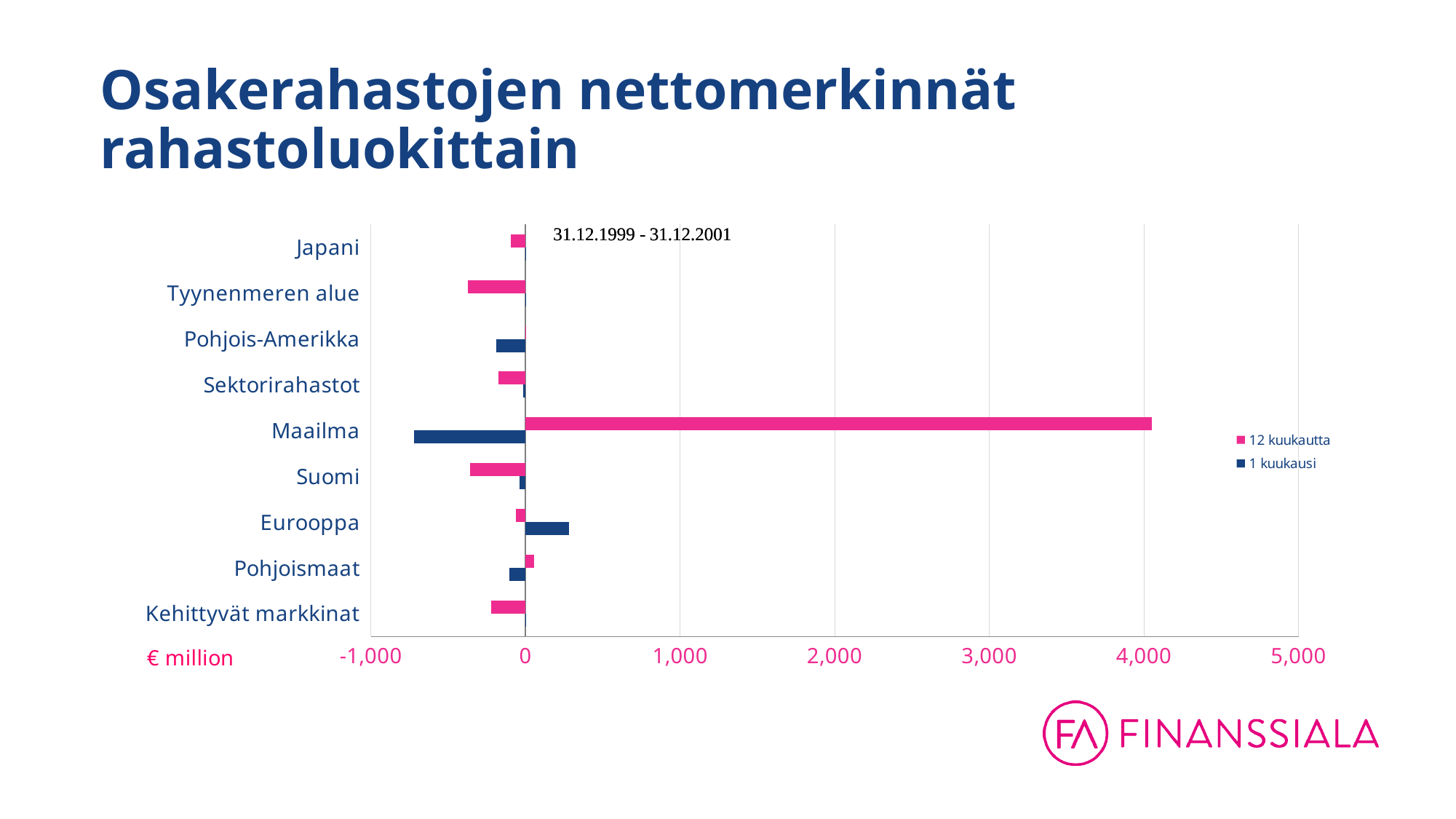
Which has the larger 1 kuukausi value, Eurooppa or Pohjoismaat? Eurooppa How many series does the chart's legend list? 2 Which category has the lowest value for the 1 kuukausi series? Maailma Is the 1 kuukausi value for Maailma greater or less than -500? less How many fund categories are listed on the vertical axis of the chart? 9 What kind of chart is shown on the slide? bar chart Which category has the highest value for the 12 kuukautta series? Maailma Which has the larger 12 kuukautta value, Maailma or Suomi? Maailma What date range is printed on the chart? 31.12.1999 - 31.12.2001 Is the 1 kuukausi value for Eurooppa greater or less than 0? greater Is the 12 kuukautta value for Maailma greater or less than 3,000? greater Which colour represents the 12 kuukautta series in the chart? pink